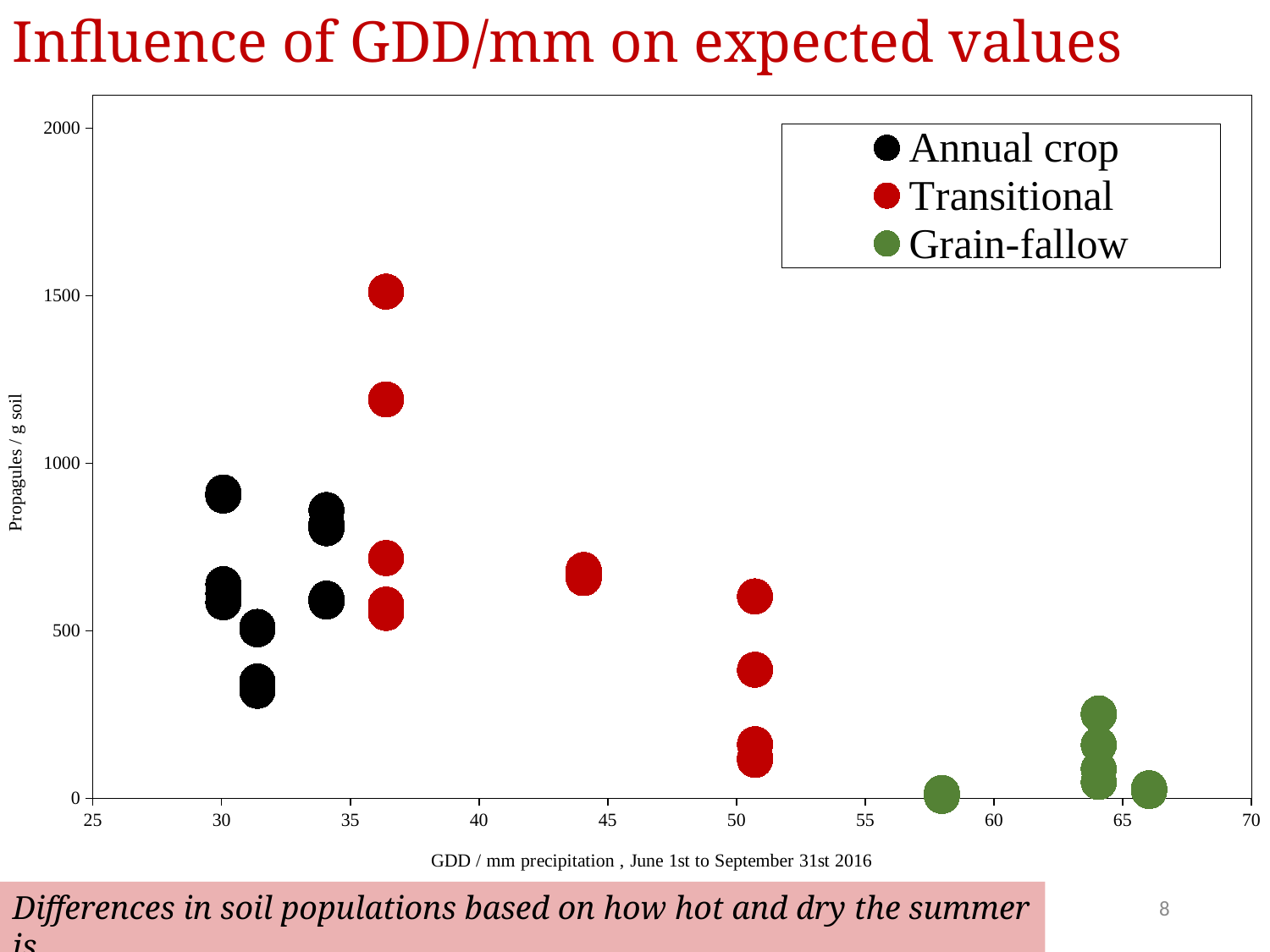
What kind of chart is shown on the slide? Scatter chart How many series does the legend list? 3 Is the highest Annual crop point greater or less than 1000 propagules / g soil? less Are all Grain-fallow points greater or less than 500 propagules / g soil? less Overall, do the Propagules / g soil values rise or fall as GDD / mm precipitation increases along the x axis? fall What is the title of the chart? Influence of GDD/mm on expected values Which series has the highest point: Annual crop or Grain-fallow? Annual crop Is the highest Transitional point greater or less than 1000 propagules / g soil? greater Which series contains the points with the lowest Propagules / g soil values? Grain-fallow What are the three series named in the legend? Annual crop, Transitional, Grain-fallow Which series contains the point with the highest Propagules / g soil value? Transitional